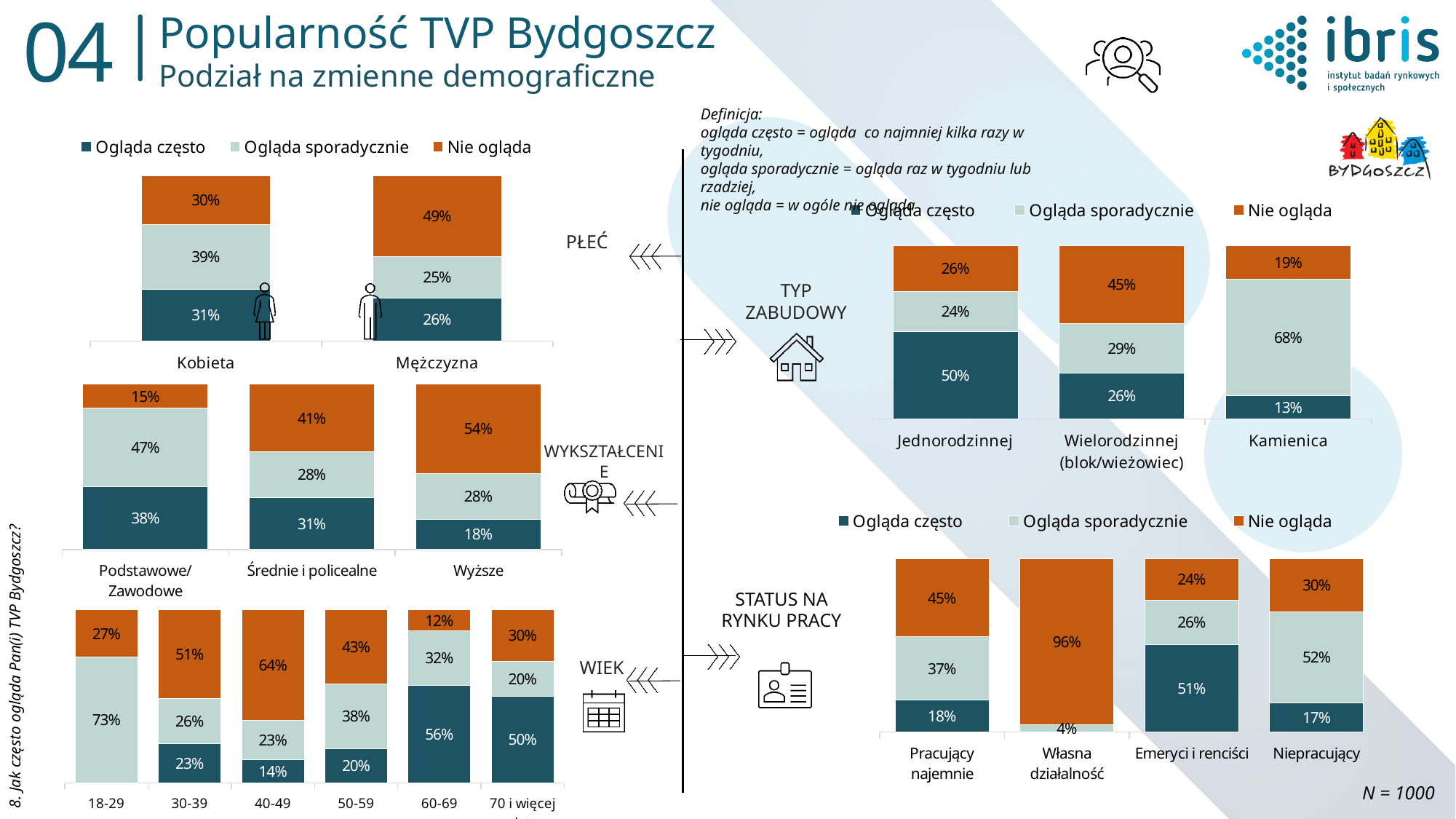
In the TYP ZABUDOWY chart, which housing type has the lowest 'Ogląda często' value? Kamienica How many age groups are shown in the WIEK chart? 6 In the TYP ZABUDOWY chart, what is the 'Ogląda sporadycznie' value for Kamienica? 68% In the STATUS NA RYNKU PRACY chart, is the 'Ogląda często' value for Emeryci i renciści larger than that for Pracujący najemnie? Yes In the PŁEĆ chart, what percentage of Kobieta is labelled 'Nie ogląda'? 30% In the WIEK chart, which age group has the highest 'Ogląda często' value? 60-69 In the WIEK chart, what is the 'Nie ogląda' value for the 40-49 age group? 64% How many series does the legend of the STATUS NA RYNKU PRACY chart list? 3 In the PŁEĆ chart, what percentage of Mężczyzna is labelled 'Ogląda często'? 26% In the PŁEĆ chart, what is the difference between the 'Nie ogląda' values for Mężczyzna and Kobieta? 19% In the WYKSZTAŁCENIE chart, which education category has the highest 'Nie ogląda' value? Wyższe In the WYKSZTAŁCENIE chart, what is the 'Ogląda sporadycznie' value for Podstawowe/Zawodowe? 47%